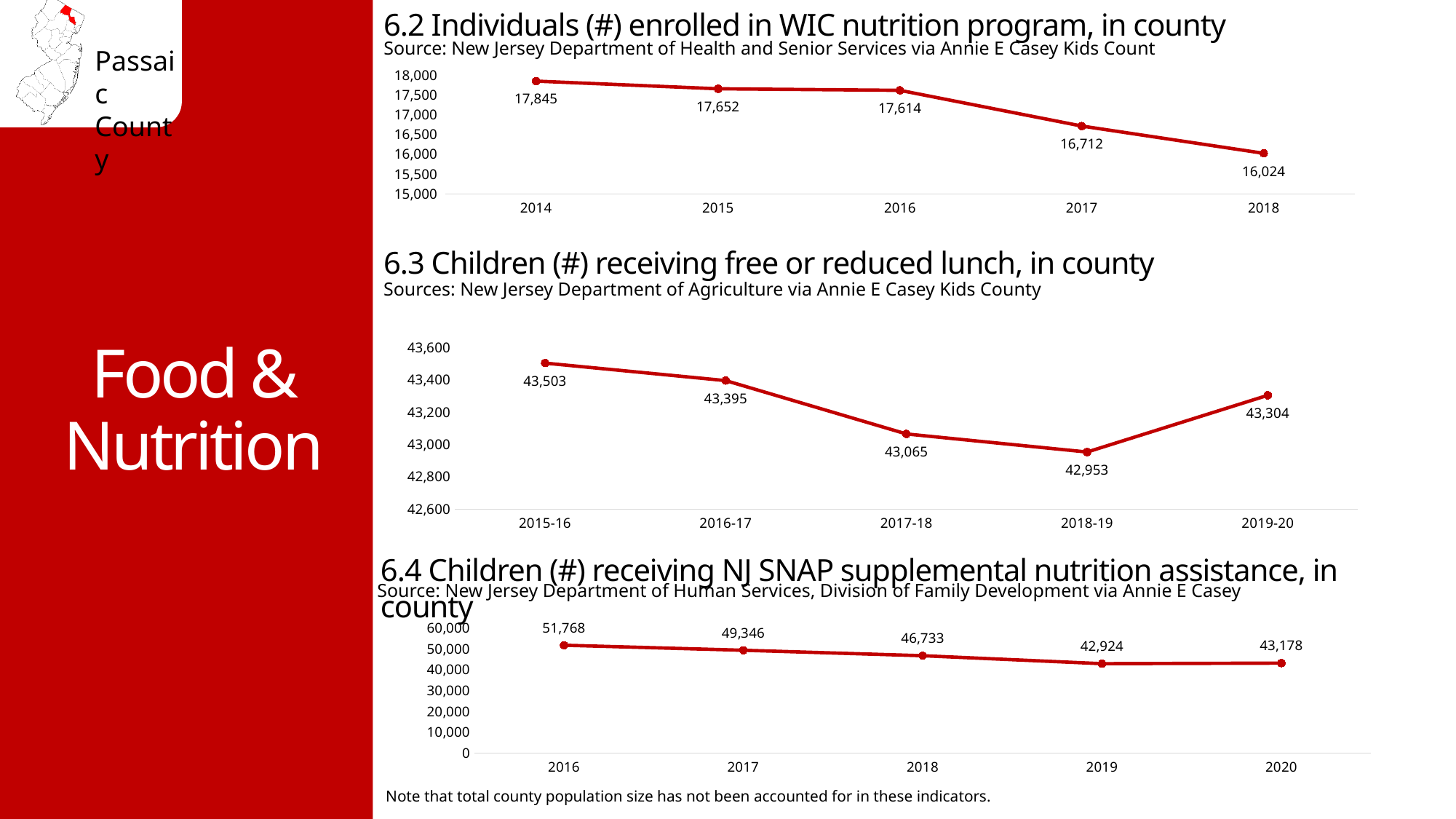
In the chart '6.2 Individuals (#) enrolled in WIC nutrition program, in county', what is the difference between the 2014 and 2018 values? 1,821 In the chart '6.4 Children (#) receiving NJ SNAP supplemental nutrition assistance, in county', what is the value for 2017? 49,346 In the chart '6.3 Children (#) receiving free or reduced lunch, in county', how many data points are plotted? 5 In the chart '6.4 Children (#) receiving NJ SNAP supplemental nutrition assistance, in county', is the value for 2019 greater or less than 50,000? less In the chart '6.2 Individuals (#) enrolled in WIC nutrition program, in county', which year has the lowest value? 2018 In the chart '6.2 Individuals (#) enrolled in WIC nutrition program, in county', do the values rise or fall from 2014 to 2018? fall In the chart '6.3 Children (#) receiving free or reduced lunch, in county', which school year has the highest value? 2015-16 What kind of chart is '6.2 Individuals (#) enrolled in WIC nutrition program, in county'? line chart In the chart '6.3 Children (#) receiving free or reduced lunch, in county', what is the value for 2018-19? 42,953 In the chart '6.2 Individuals (#) enrolled in WIC nutrition program, in county', what is the value for 2016? 17,614 In the chart '6.3 Children (#) receiving free or reduced lunch, in county', which is larger, the value for 2016-17 or the value for 2019-20? 2016-17 In the chart '6.4 Children (#) receiving NJ SNAP supplemental nutrition assistance, in county', what is the difference between the 2016 and 2020 values? 8,590